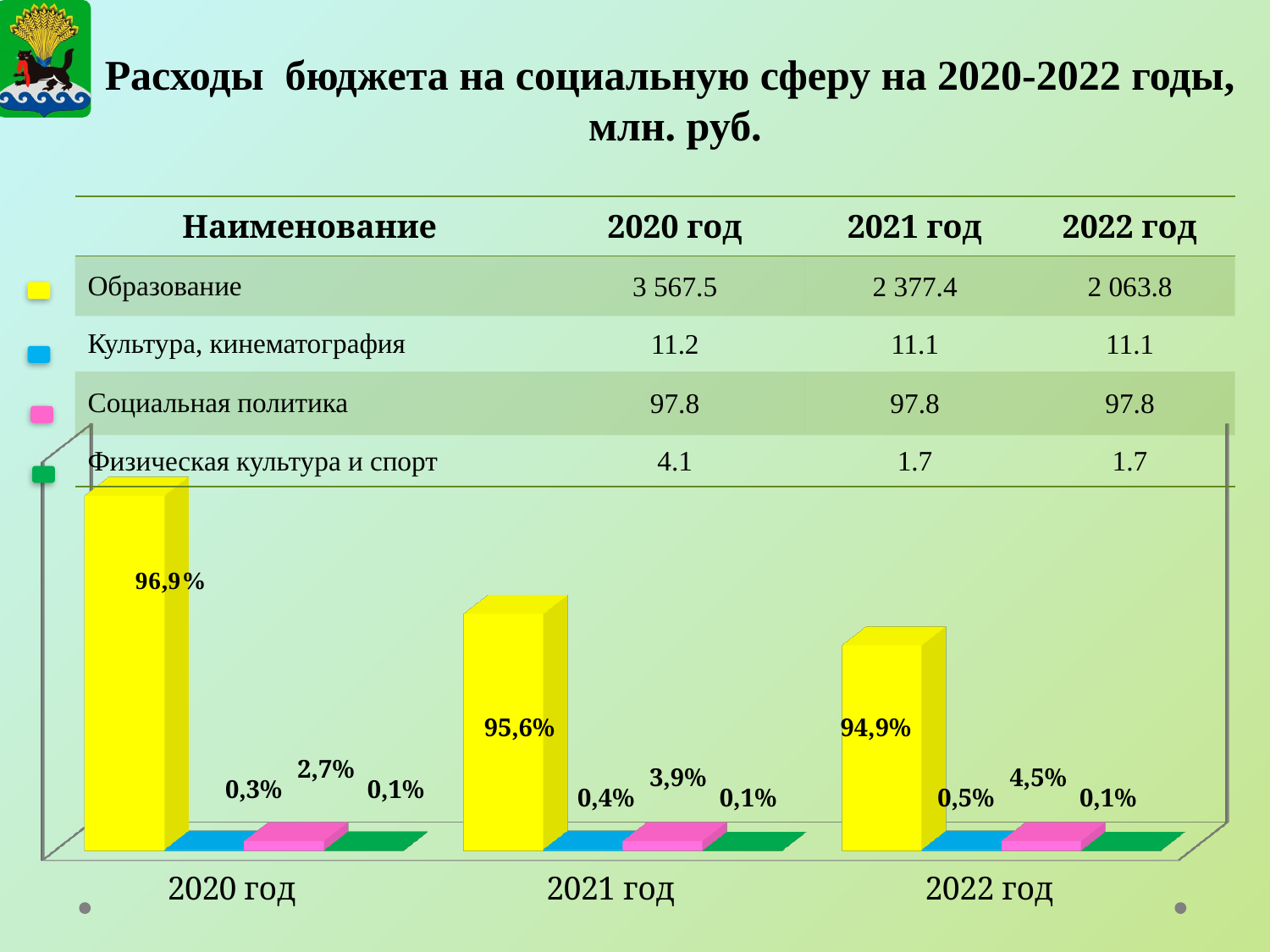
What is the data label on the pink bar (Социальная политика) for 2021 год? 3,9% In which year is the yellow bar (Образование) the highest? 2020 год How many year categories are shown on the x axis of the chart? 3 What is the data label on the blue bar (Культура, кинематография) for 2022 год? 0,5% Which is larger: the pink bar label for 2022 год or the pink bar label for 2020 год? 2022 год What is the difference between the yellow bar labels for 2020 год and 2022 год? 2,0% What kind of chart is shown on the slide? bar chart What is the data label on the yellow bar (Образование) for 2020 год? 96,9% What is the data label on the yellow bar (Образование) for 2022 год? 94,9% Does the yellow bar (Образование) rise or fall from 2020 год to 2022 год? fall What is the data label on the green bar (Физическая культура и спорт) for 2020 год? 0,1%